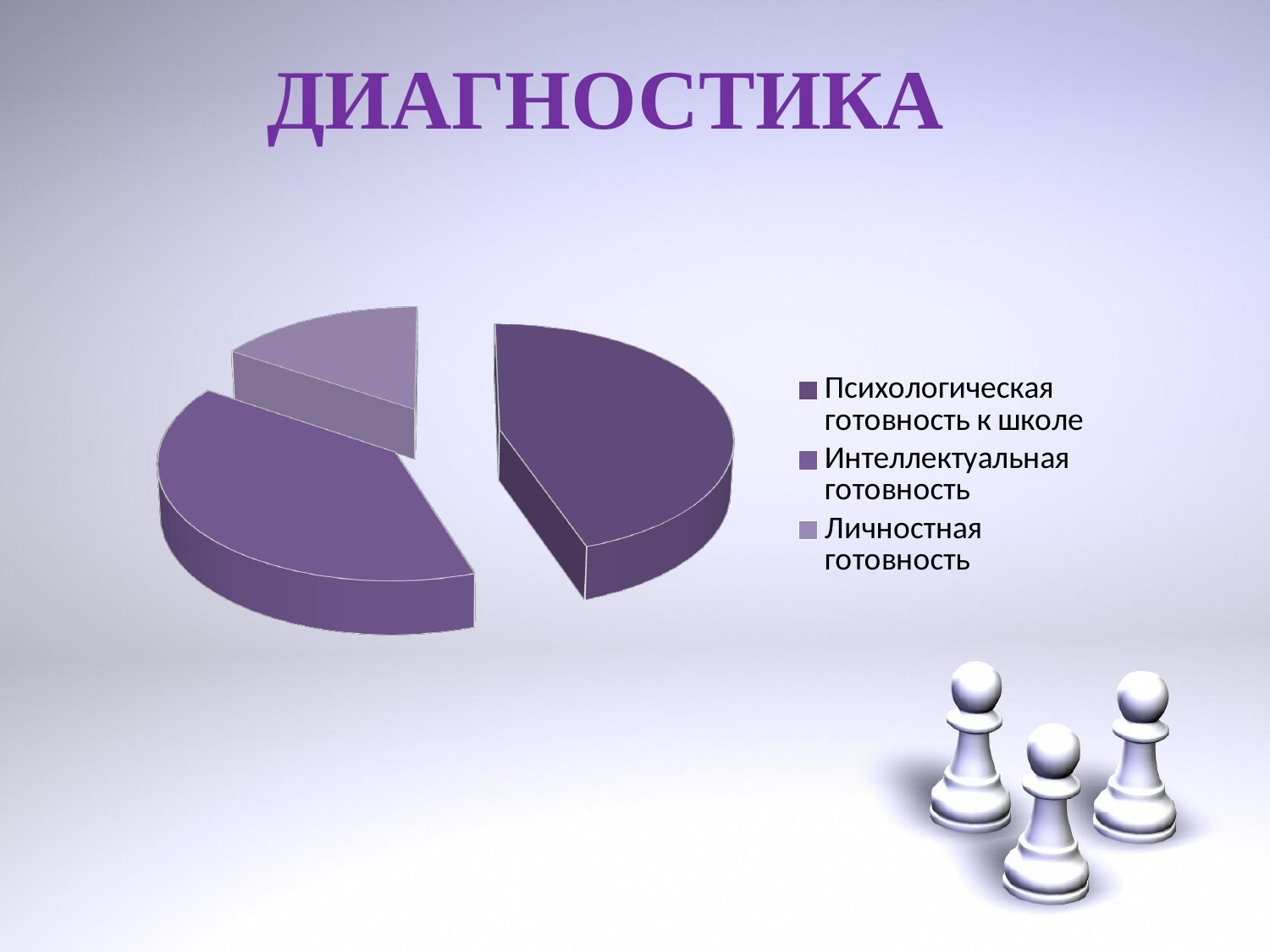
Which legend entry is shown in the lightest shade of purple? Личностная готовность How many entries does the legend of the pie chart list? 3 How many slices does the pie chart have? 3 Which slice is larger: Интеллектуальная готовность or Личностная готовность? Интеллектуальная готовность Which category has the smallest slice in the pie chart? Личностная готовность What kind of chart is shown on the slide? pie chart What is the title of the slide containing the pie chart? ДИАГНОСТИКА Which slice is larger: Психологическая готовность к школе or Личностная готовность? Психологическая готовность к школе